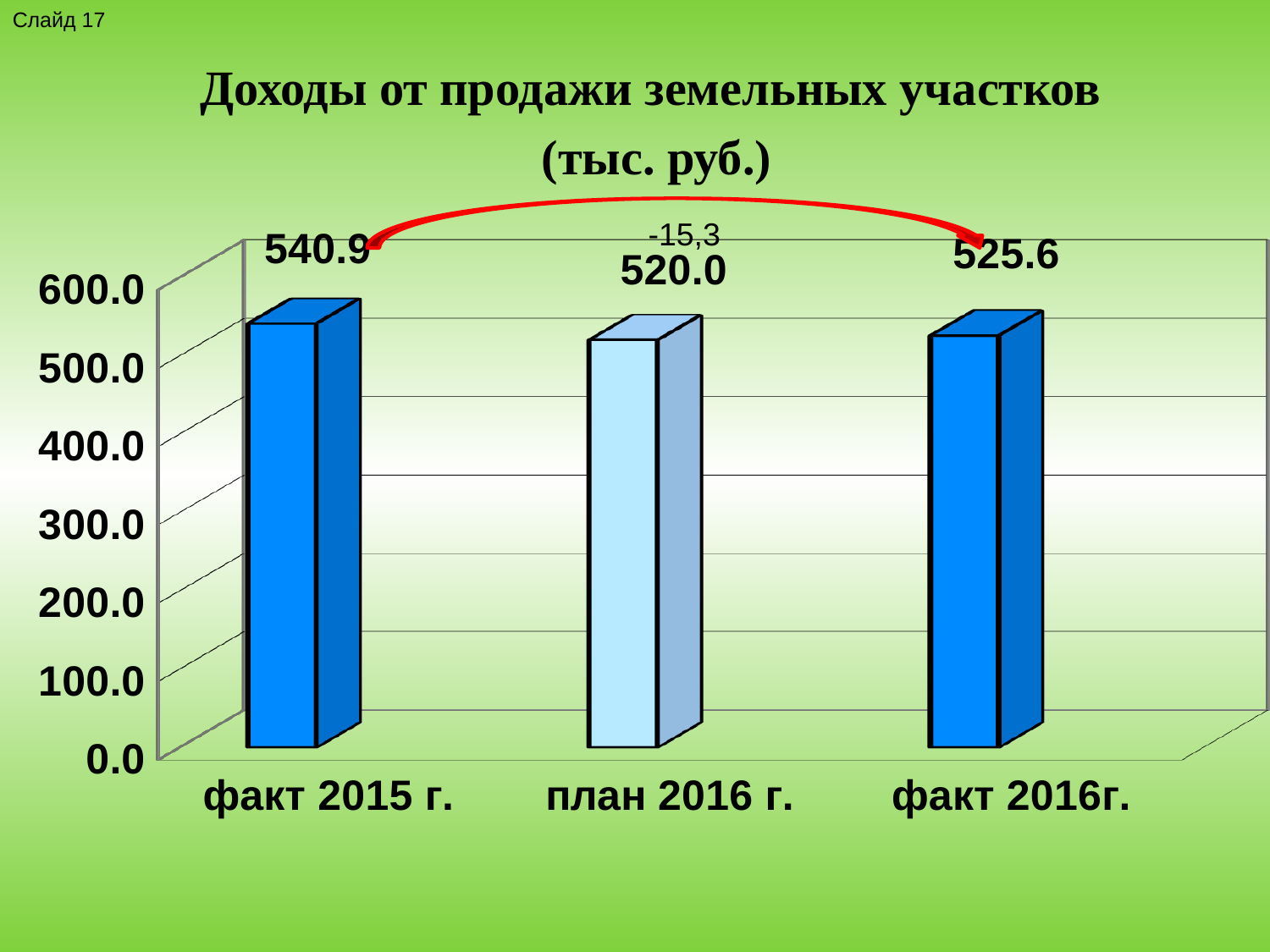
Which category has the highest value? факт 2015 г. What is the value for факт 2015 г.? 540.9 What kind of chart is shown on the slide? bar chart Which category has the lowest value? план 2016 г. Is the value for план 2016 г. greater or less than 600.0? less What is the value for план 2016 г.? 520.0 Which is larger, факт 2015 г. or план 2016 г.? факт 2015 г. What is the difference between факт 2016г. and план 2016 г.? 5.6 What is the title of the chart? Доходы от продажи земельных участков (тыс. руб.) What is the value for факт 2016г.? 525.6 How many categories are shown on the chart? 3 What is the difference between факт 2015 г. and факт 2016г.? 15.3